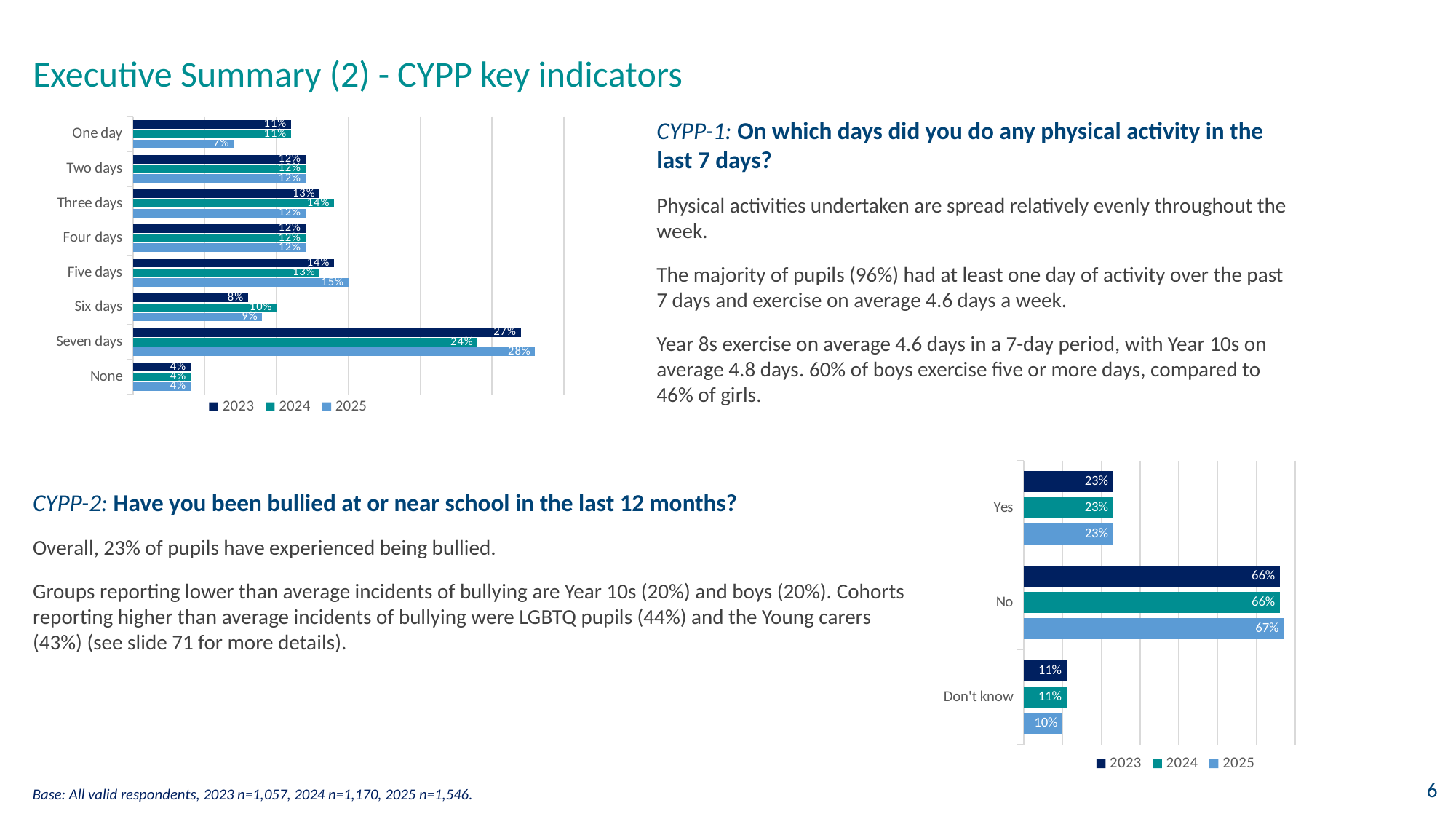
In the top-left chart, which is larger for One day: the 2023 value or the 2025 value? 2023 In the top-left chart, which category has the lowest value for 2025? None In the top-left chart, what is the 2025 value for Seven days? 28% In the bottom-right chart, what is the 2025 value for No? 67% In the top-left chart, which category has the highest value for 2023? Seven days What kind of chart is the bottom-right chart? Bar chart In the bottom-right chart, what is the difference between the 2023 value for No and the 2023 value for Yes? 43% How many categories are shown on the y axis of the top-left chart? 8 In the top-left chart, what is the difference between the 2023 and 2024 values for Seven days? 3% In the top-left chart, what is the 2024 value for Six days? 10% How many series does the legend of the top-left chart list? 3 In the bottom-right chart, which category has the lowest value for 2025? Don't know